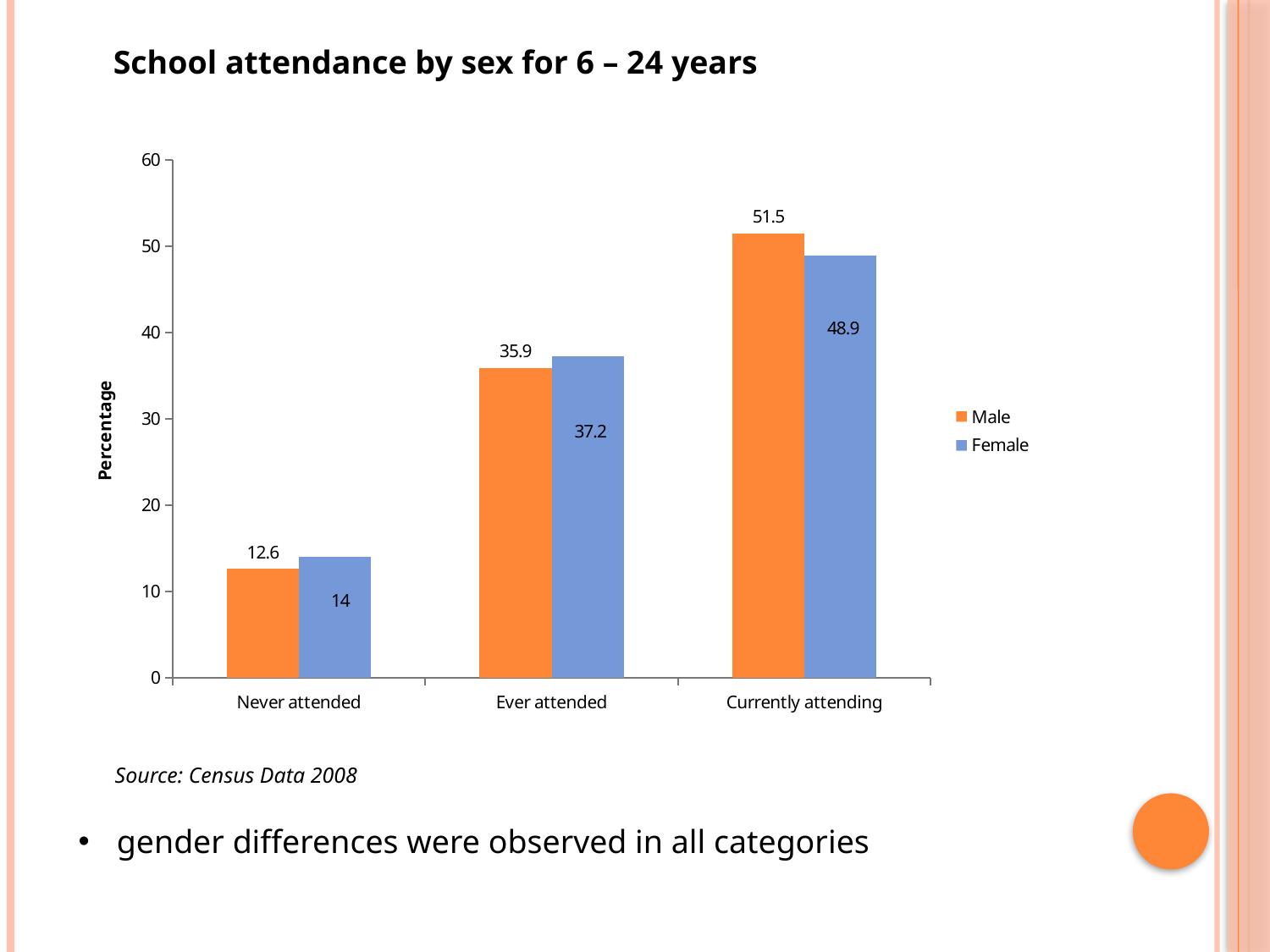
What is the Female value for Never attended? 14 Which category has the highest Male value? Currently attending Which category has the lowest Female value? Never attended Which is larger for Ever attended, the Male value or the Female value? Female What kind of chart is shown on the slide? Bar chart Is the Female value for Currently attending greater or less than 40? greater What is the Male value for Never attended? 12.6 What is the Female value for Ever attended? 37.2 How many categories are shown on the x axis? 3 How many series does the legend list? 2 What is the Male value for Currently attending? 51.5 What is the difference between the Male and Female values for Currently attending? 2.6